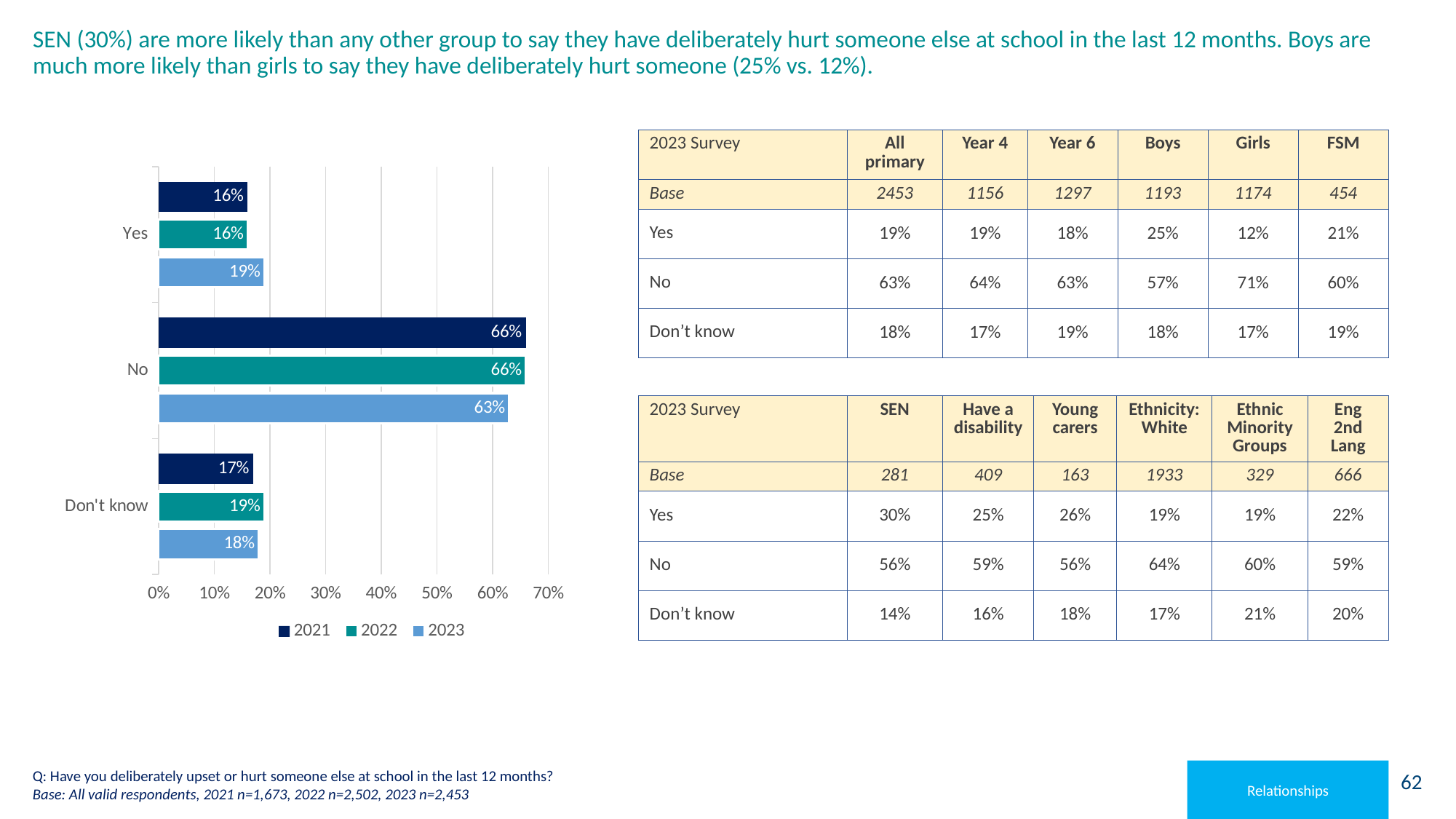
Which series is shown in the darkest blue colour? 2021 What is the value for 'No' in 2021? 66% Which is larger: the 'Yes' value in 2023 or the 'Don't know' value in 2023? Yes What is the value for 'Yes' in 2023? 19% Is the value for 'No' in 2023 greater or less than 60%? greater What is the value for 'Don't know' in 2022? 19% How many categories are shown on the chart? 3 Which category has the highest value in 2023? No What kind of chart is shown on the slide? bar chart How many series does the legend list? 3 What is the difference between the 'No' value in 2022 and the 'No' value in 2023? 3% Which category has the lowest value in 2021? Yes